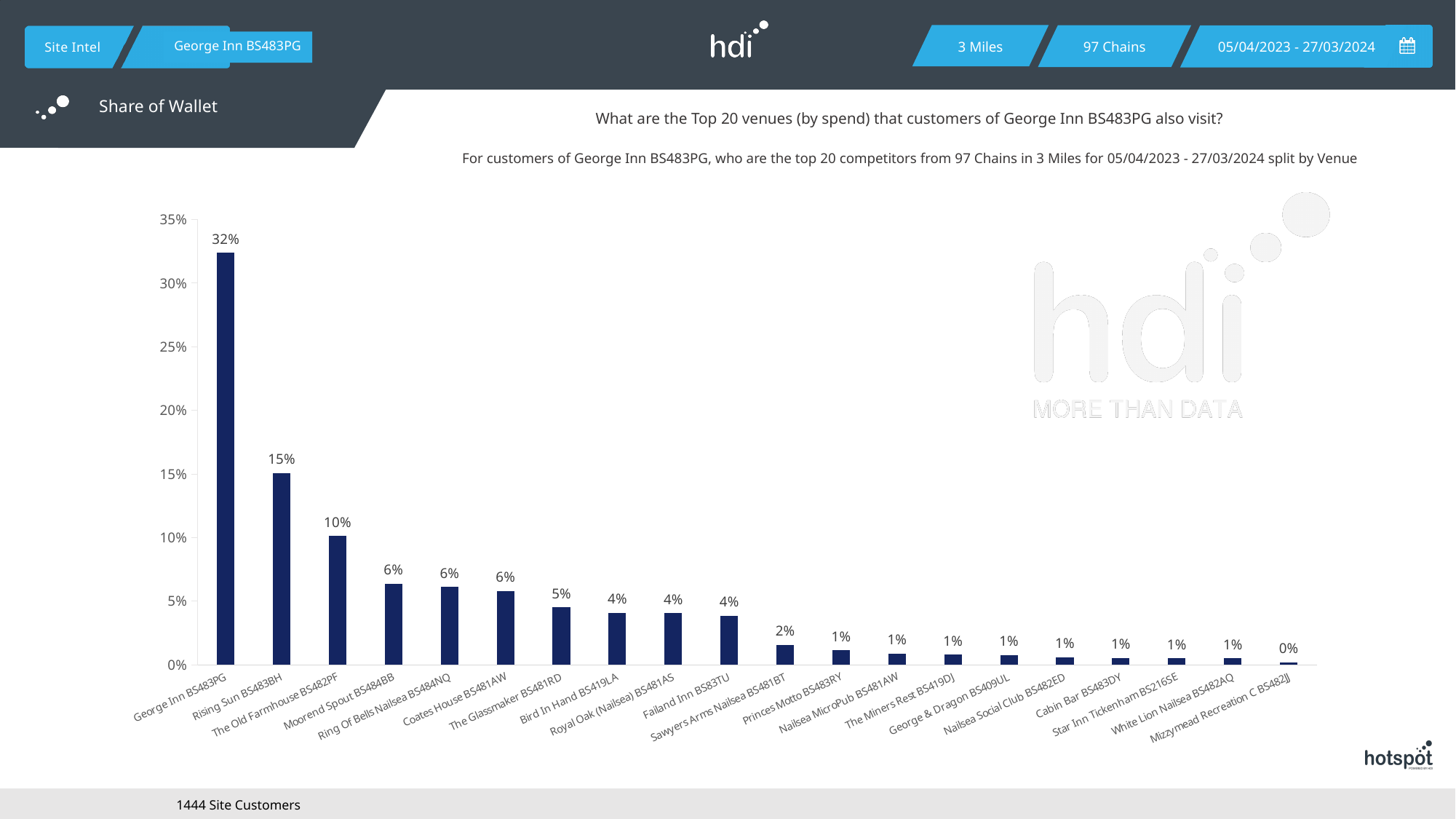
What is the value for Rising Sun BS483BH? 15% Which venue has the lowest value? Mizzymead Recreation C BS482JJ Which venue has the highest value? George Inn BS483PG Do the values rise or fall from left to right along the x axis? fall What is the difference between the values for George Inn BS483PG and Rising Sun BS483BH? 17% How many venues are shown on the x axis? 20 What is the value for George Inn BS483PG? 32% Is the value for George Inn BS483PG greater or less than 30%? greater Which is larger, the value for Rising Sun BS483BH or The Old Farmhouse BS482PF? Rising Sun BS483BH What is the value for Sawyers Arms Nailsea BS481BT? 2% What is the value for The Old Farmhouse BS482PF? 10% What kind of chart is shown on the slide? bar chart